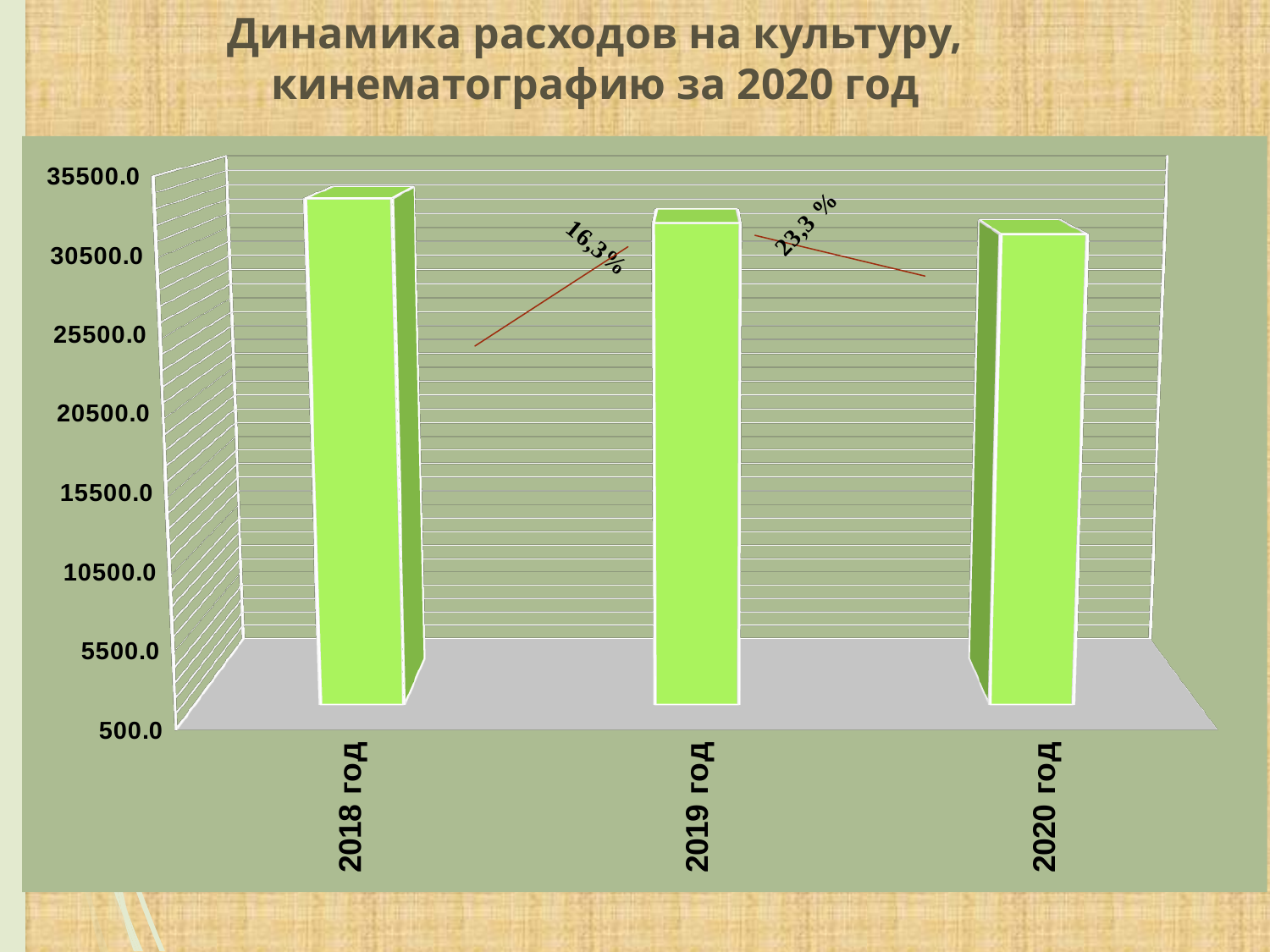
What is the title of the chart on the slide? Динамика расходов на культуру, кинематографию за 2020 год Which is larger, the value for 2018 год or the value for 2019 год? 2018 год Is the value for 2018 год greater or less than 35500.0? less Do the values rise or fall from 2018 to 2020 along the x axis? fall Is the value for 2020 год greater or less than 25500.0? greater Is the value for 2018 год greater or less than 30500.0? greater Which is larger, the value for 2018 год or the value for 2020 год? 2018 год Which year has the highest bar on the chart? 2018 год What percentage label is written between the 2018 and 2019 bars? 16,3% What kind of chart is shown on the slide? bar chart How many years (categories) are plotted on the chart? 3